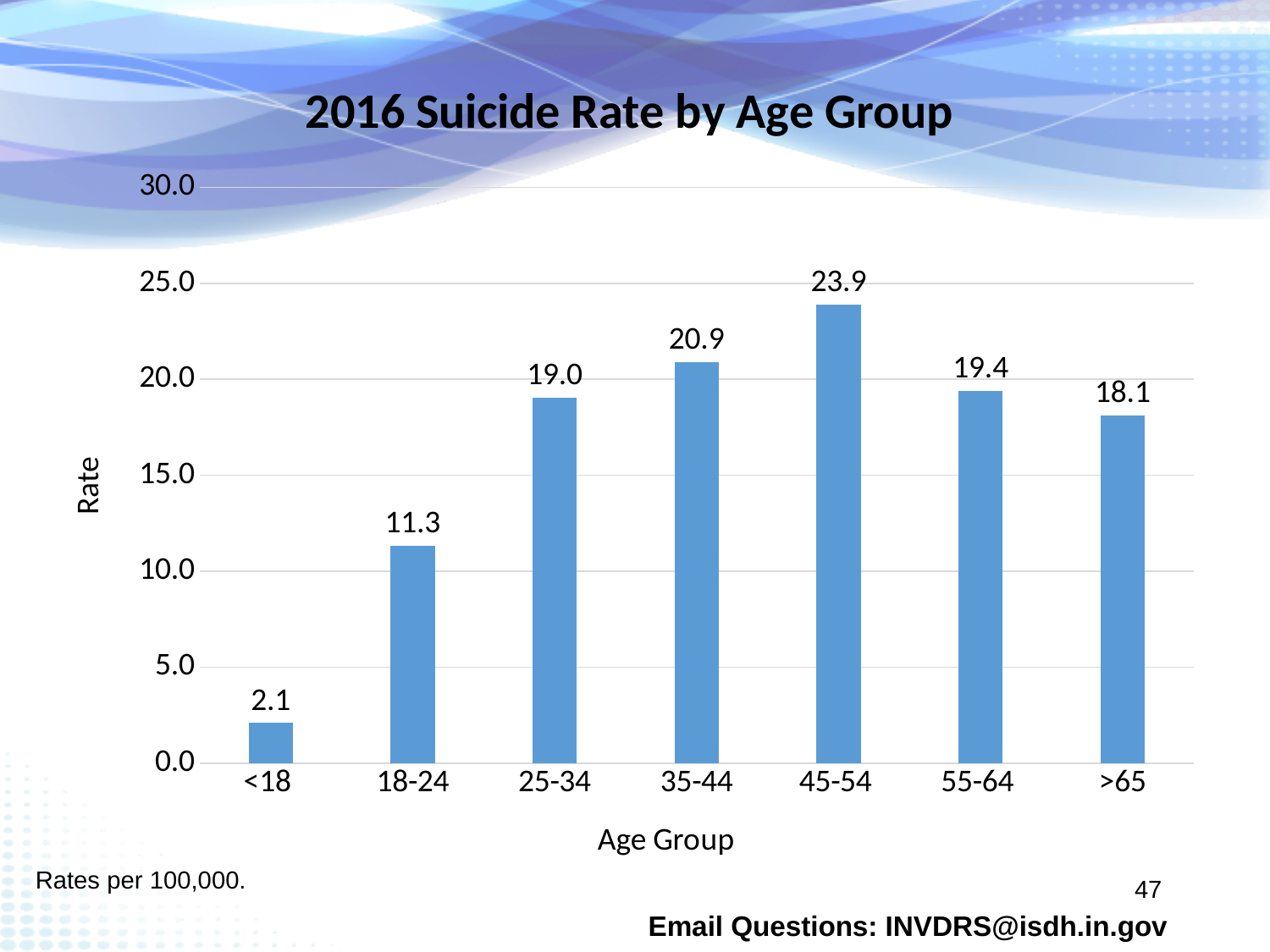
Which age group has the lowest suicide rate? <18 Is the suicide rate for the >65 age group greater or less than 20.0? less What is the suicide rate for the 18-24 age group? 11.3 Which age group has the highest suicide rate? 45-54 What is the suicide rate for the <18 age group? 2.1 What kind of chart is shown on the slide? bar chart Does the suicide rate rise or fall from the <18 age group to the 45-54 age group? rise What is the difference between the suicide rates for the 45-54 and 35-44 age groups? 3.0 Which age group has a higher suicide rate, 25-34 or 55-64? 55-64 How many age groups are shown on the chart? 7 What is the suicide rate for the 45-54 age group? 23.9 What is the title of the chart? 2016 Suicide Rate by Age Group